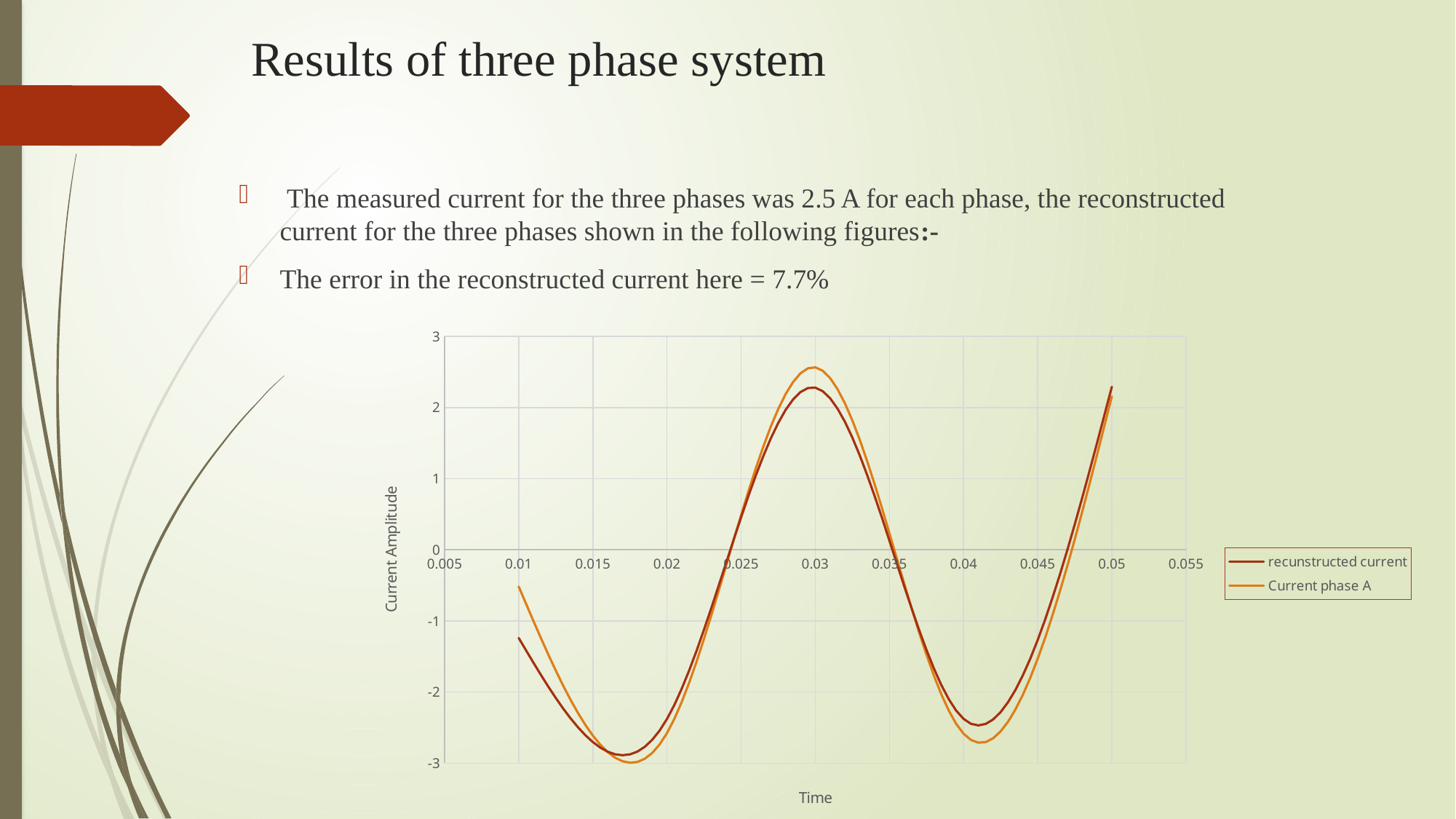
Is the minimum value of Current phase A near time 0.04 greater or less than -2? less Do the values of Current phase A rise or fall between time 0.02 and time 0.03? rise How many series does the chart's legend list? 2 At the trough near time 0.04, which series has the lower value, recunstructed current or Current phase A? Current phase A What is the label of the chart's vertical axis? Current Amplitude At the peak near time 0.03, which series reaches the higher value, recunstructed current or Current phase A? Current phase A Is the value of the recunstructed current at time 0.01 greater or less than -1? less Do the values of the recunstructed current rise or fall between time 0.03 and time 0.04? fall What are the two series named in the chart's legend? recunstructed current and Current phase A What kind of chart is shown on the slide? line chart Is the value of Current phase A at time 0.01 greater or less than -1? greater